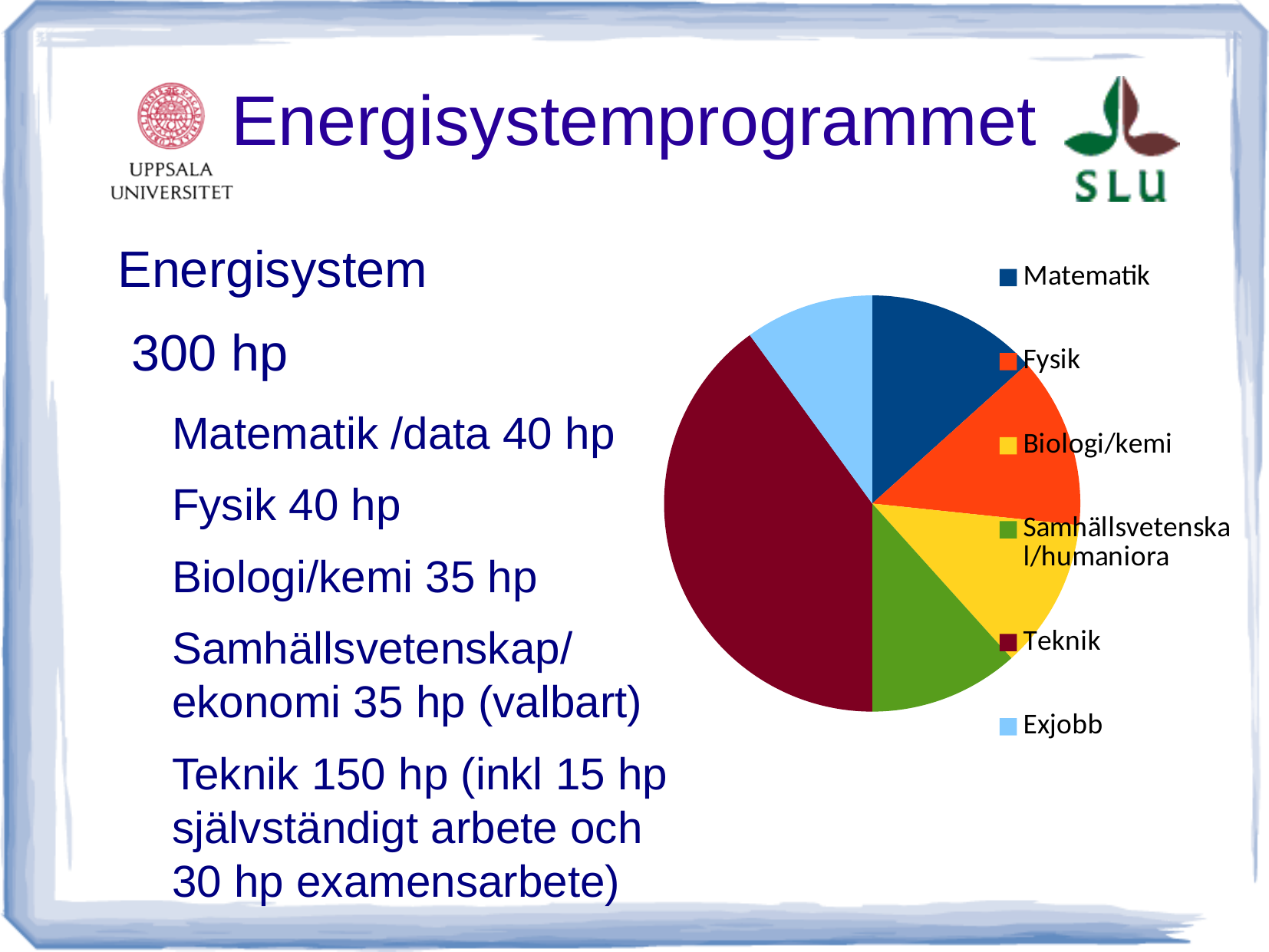
Which colour represents Teknik in the pie chart? dark red Which legend entry is shown in light blue? Exjobb What kind of chart is shown on the slide? pie chart Does the Teknik slice take up more or less than half of the pie? less How many entries does the legend of the pie chart list? 6 How many slices does the pie chart have? 6 Which slice is larger in the pie chart, Teknik or Matematik? Teknik Which category has the largest slice in the pie chart? Teknik Which slice is larger in the pie chart, Teknik or Fysik? Teknik